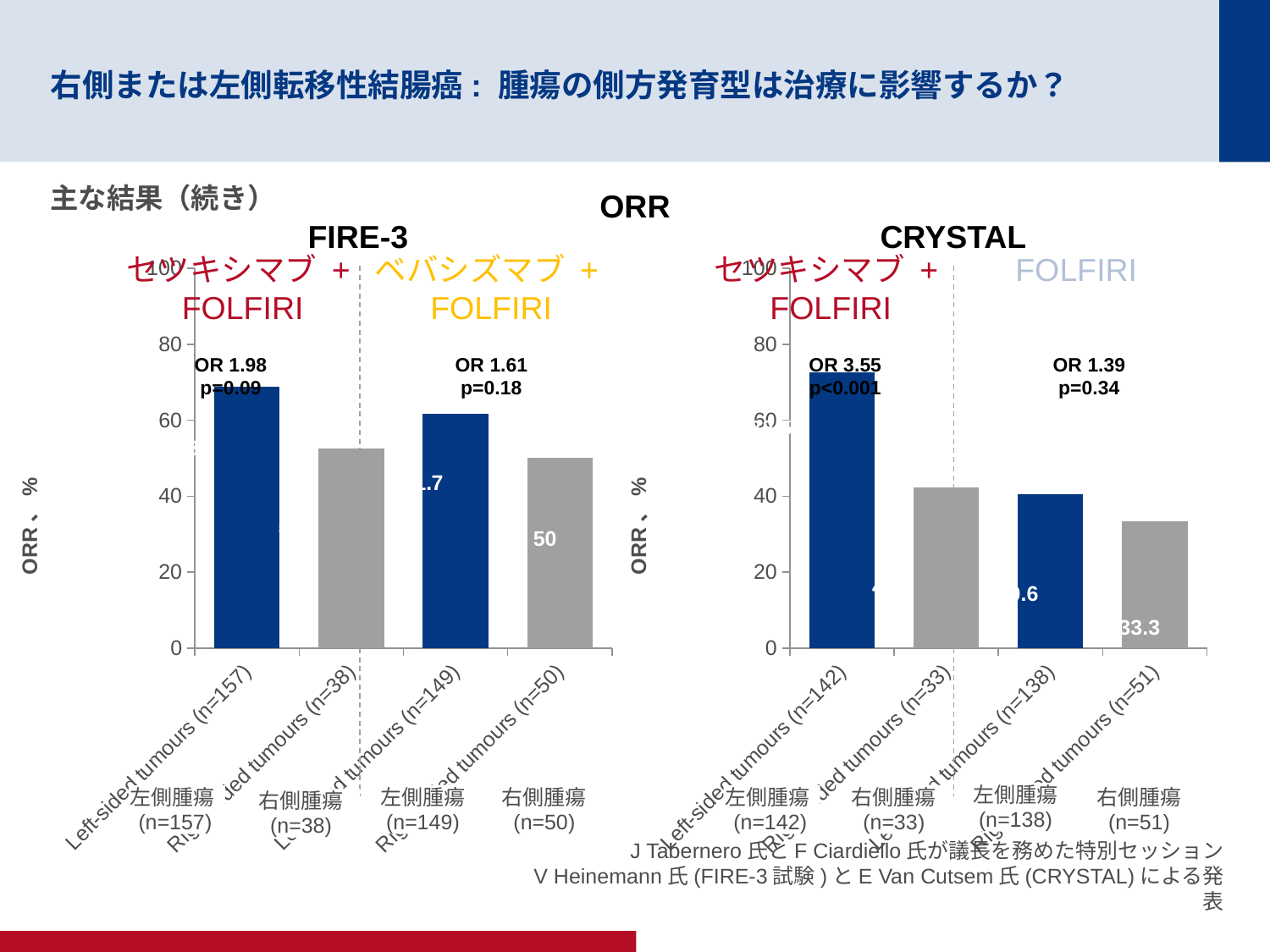
In the CRYSTAL chart, which category has the lowest ORR? Right-sided tumours (n=51) In the CRYSTAL chart, which has the higher ORR: right-sided tumours (n=33) or right-sided tumours (n=51)? Right-sided tumours (n=33) In the FIRE-3 chart, is the ORR for right-sided tumours (n=38) greater or less than 60? less In the CRYSTAL chart, which category has the highest ORR? Left-sided tumours (n=142) In the FIRE-3 chart, which has the higher ORR: left-sided tumours (n=157) or left-sided tumours (n=149)? Left-sided tumours (n=157) How many bars are plotted in the CRYSTAL chart? 4 What type of chart is the FIRE-3 chart? Bar chart In the FIRE-3 chart, what is the ORR value for right-sided tumours (n=50)? 50 In the CRYSTAL chart, what is the ORR value for right-sided tumours (n=51)? 33.3 In the CRYSTAL chart, is the ORR for left-sided tumours (n=142) greater or less than 60? greater In the FIRE-3 chart, is the ORR for left-sided tumours (n=157) greater or less than 60? greater In the FIRE-3 chart, which category has the highest ORR? Left-sided tumours (n=157)